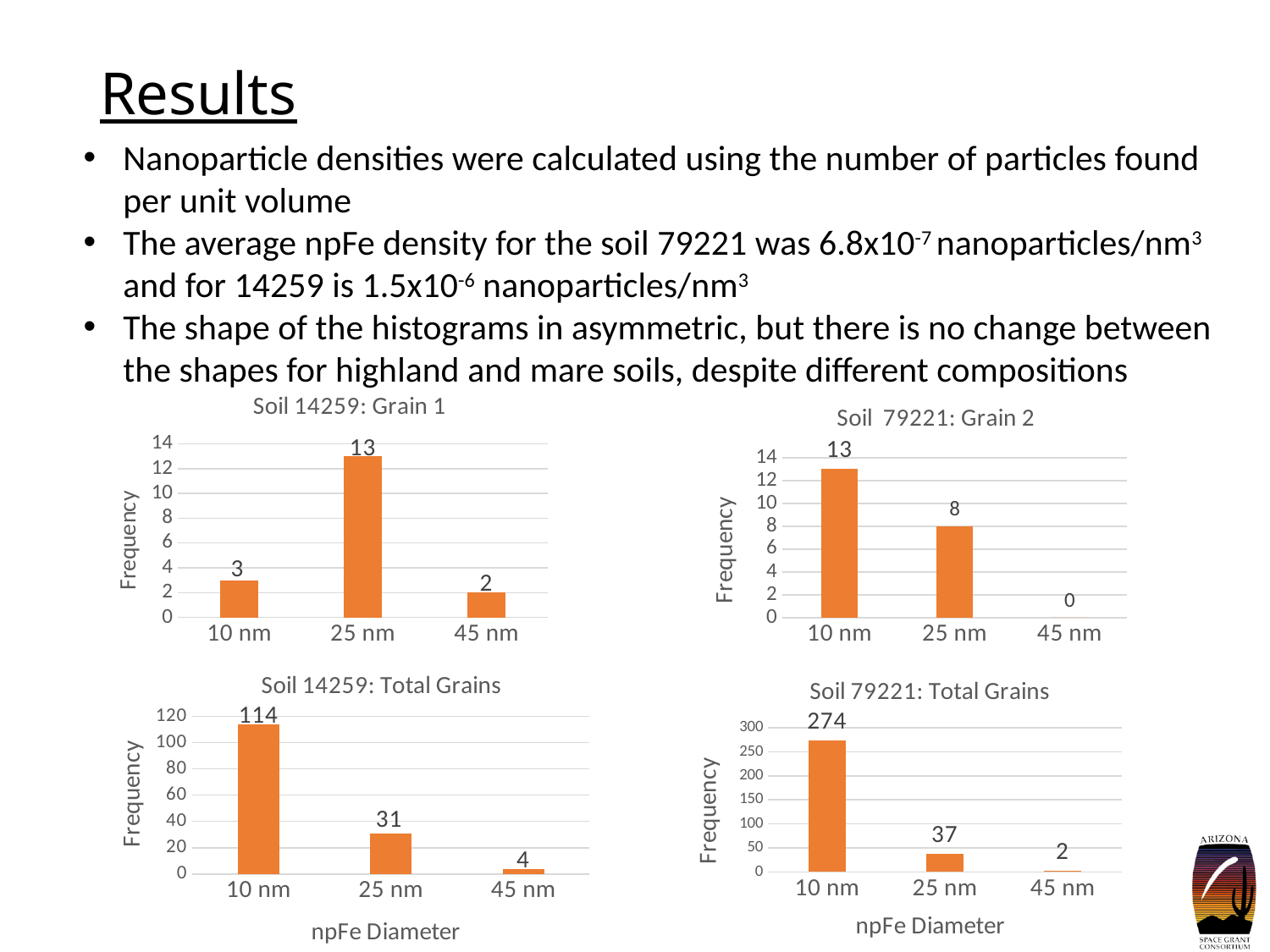
In the 'Soil 79221: Total Grains' chart, what is the frequency for 25 nm? 37 In the 'Soil 14259: Total Grains' chart, which npFe diameter has the highest frequency? 10 nm In the 'Soil 14259: Total Grains' chart, what is the difference between the frequencies for 25 nm and 45 nm? 27 In the 'Soil 14259: Total Grains' chart, what is the frequency for 10 nm? 114 In the 'Soil 79221: Total Grains' chart, which is larger, the frequency for 10 nm or for 25 nm? 10 nm In the 'Soil 79221: Grain 2' chart, what is the frequency for 45 nm? 0 How many npFe diameter categories are shown in the 'Soil 14259: Grain 1' chart? 3 In the 'Soil 14259: Grain 1' chart, which npFe diameter has the lowest frequency? 45 nm In the 'Soil 79221: Total Grains' chart, do the frequencies rise or fall from 10 nm to 45 nm? fall In the 'Soil 14259: Grain 1' chart, what is the frequency for 25 nm? 13 In the 'Soil 79221: Grain 2' chart, what is the difference between the frequencies for 10 nm and 25 nm? 5 What kind of chart is 'Soil 79221: Grain 2'? bar chart